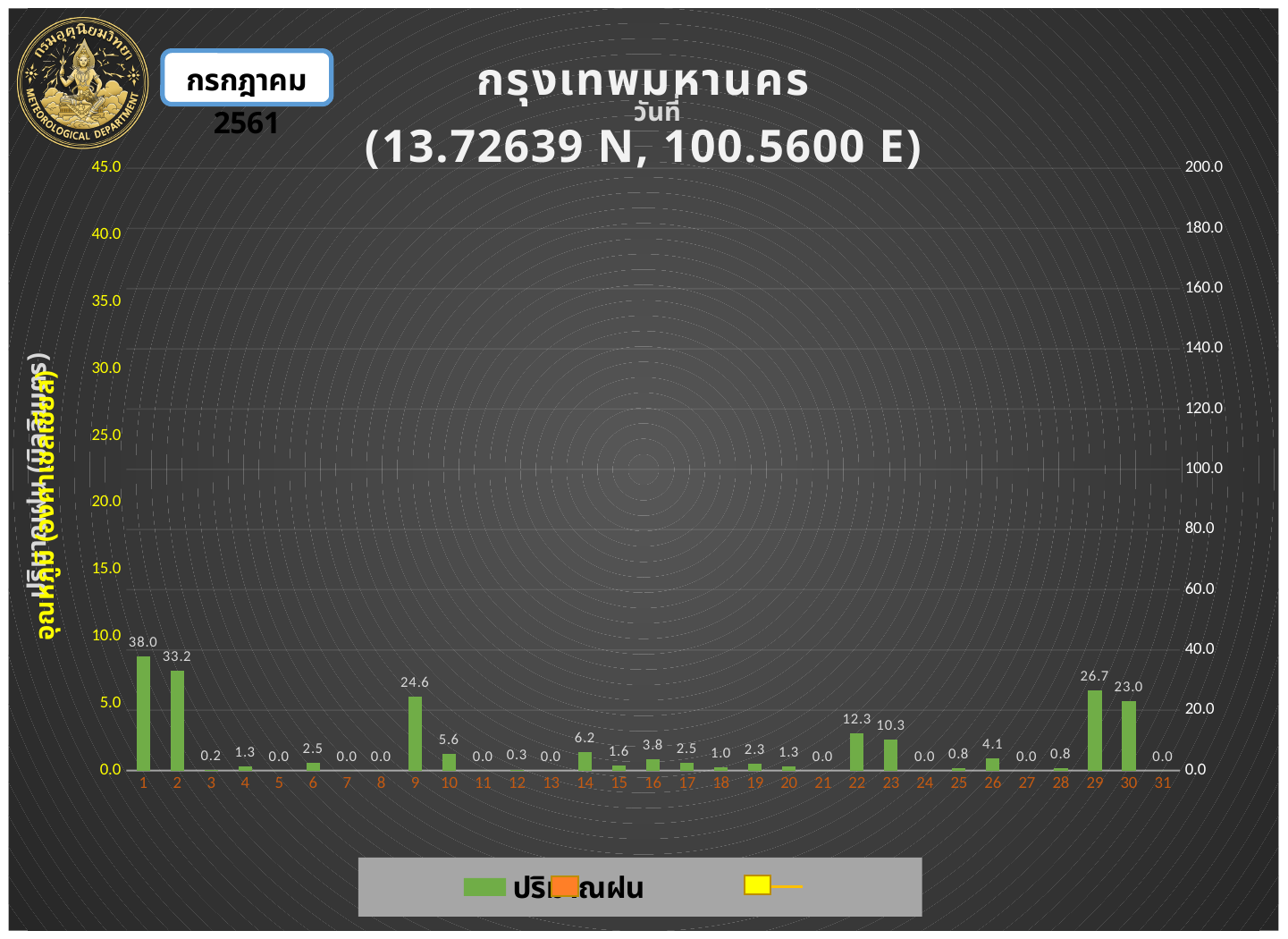
Which has the larger value, day 29 or day 9? day 29 What is the value for day 22? 12.3 Which has the larger value, day 22 or day 23? day 22 What is the value for day 30? 23.0 Which day has the highest value? 1 What coordinates are given in the chart title? 13.72639 N, 100.5600 E What is the difference between the values for day 29 and day 30? 3.7 What is the value for day 9? 24.6 How many days are shown on the x axis? 31 What kind of chart is shown? bar chart What is the value for day 1? 38.0 What is the difference between the values for day 1 and day 2? 4.8